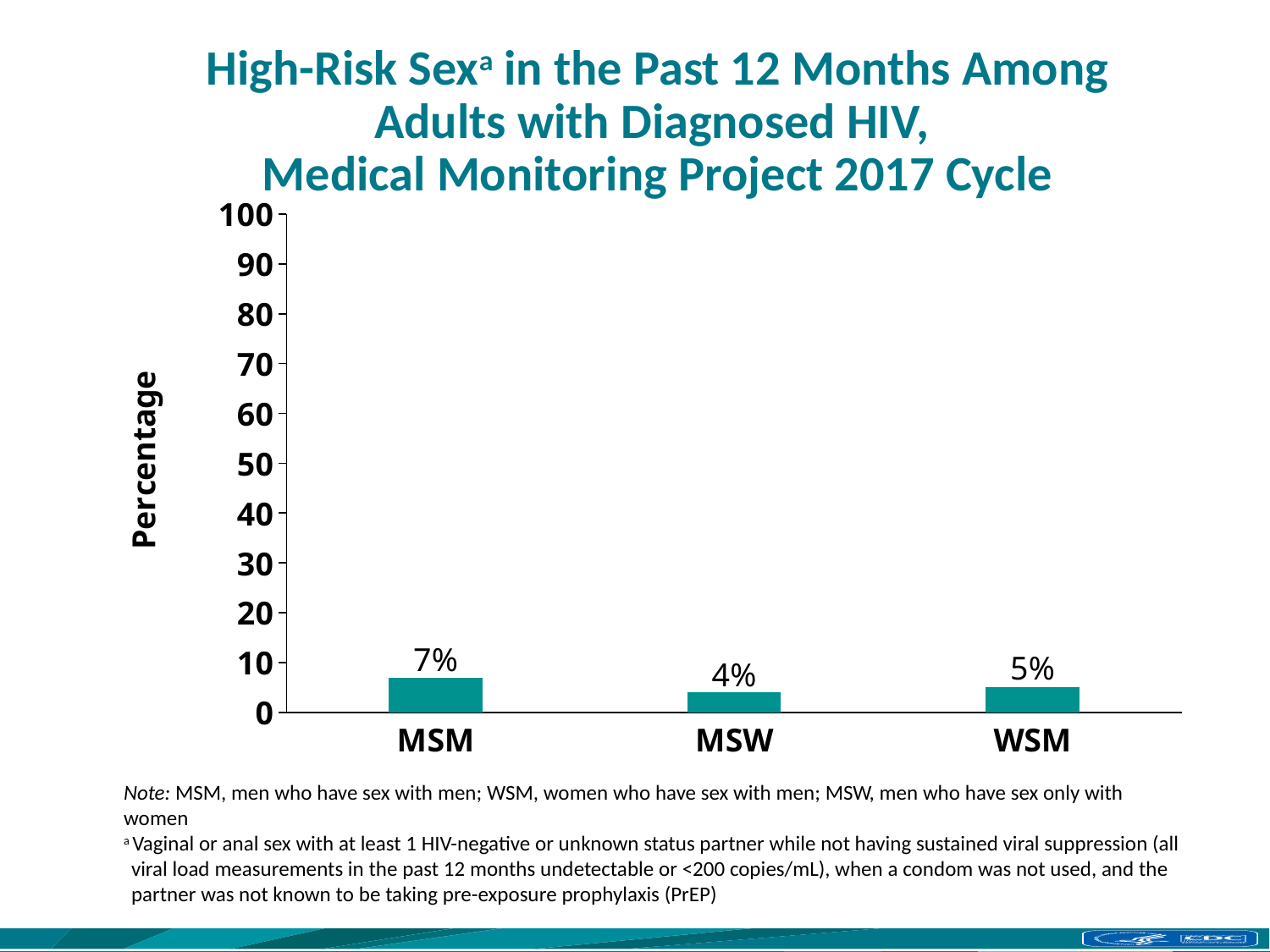
What is the difference in percentage between MSM and MSW? 3% Is the value for MSM greater or less than 10? less What is the percentage for WSM? 5% What is the difference in percentage between WSM and MSW? 1% What is the percentage for MSW? 4% Which is larger, the percentage for MSM or for WSM? MSM What is the percentage for MSM? 7% What is the label of the y axis? Percentage What kind of chart is shown on the slide? bar chart Which group has the highest percentage? MSM Which group has the lowest percentage? MSW How many groups are shown on the x axis? 3